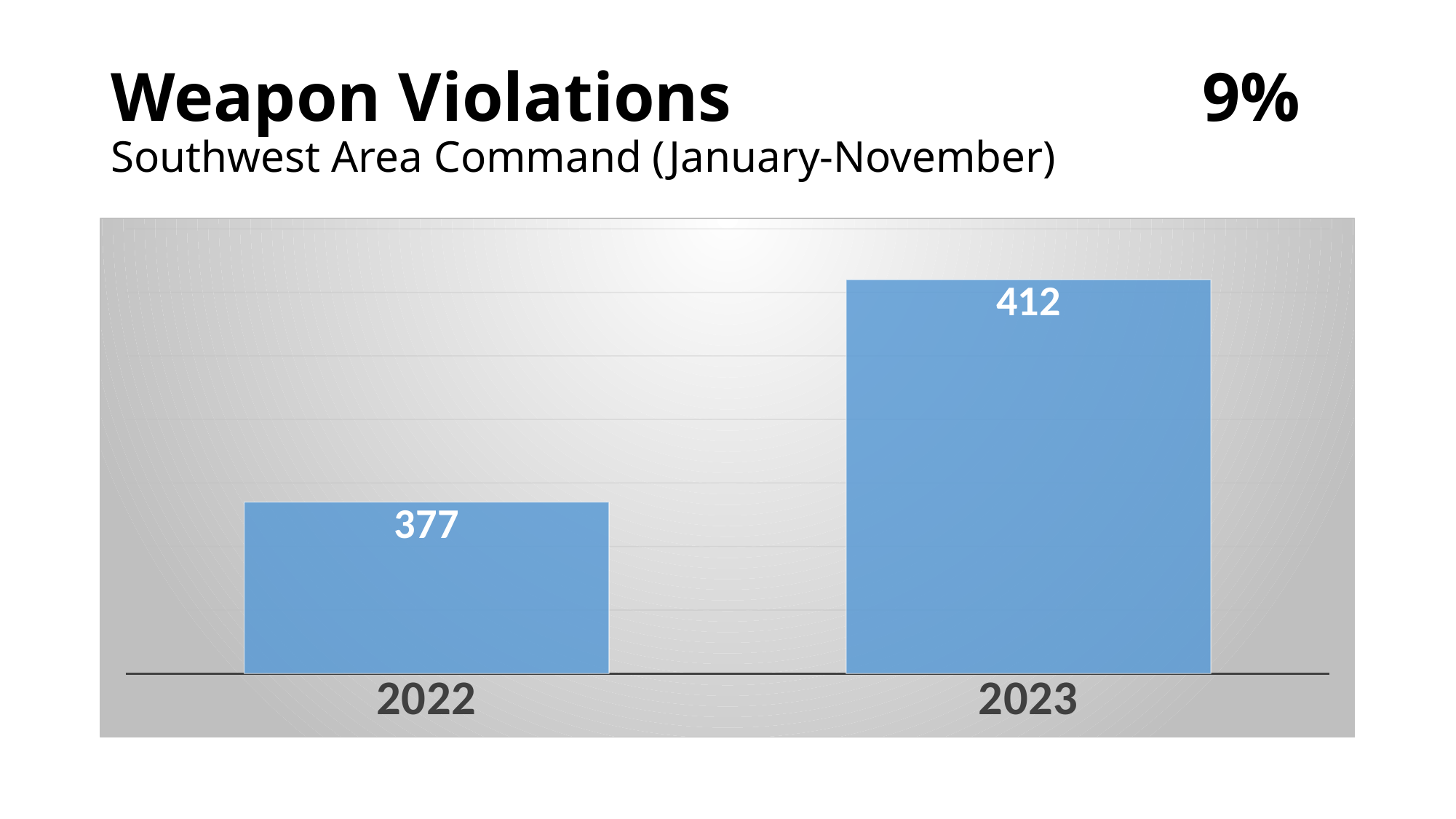
What is the value for 2023? 412 Which year has the highest value? 2023 What is the value for 2022? 377 Which year has the lowest value? 2022 Do the values rise or fall from 2022 to 2023? rise What is the difference between the 2023 and 2022 values? 35 Which is larger, the value for 2022 or the value for 2023? 2023 What kind of chart is shown on the slide? bar chart What percentage change is shown in the top right corner of the slide? 9% How many categories are shown on the x axis? 2 What is the title of the chart? Weapon Violations